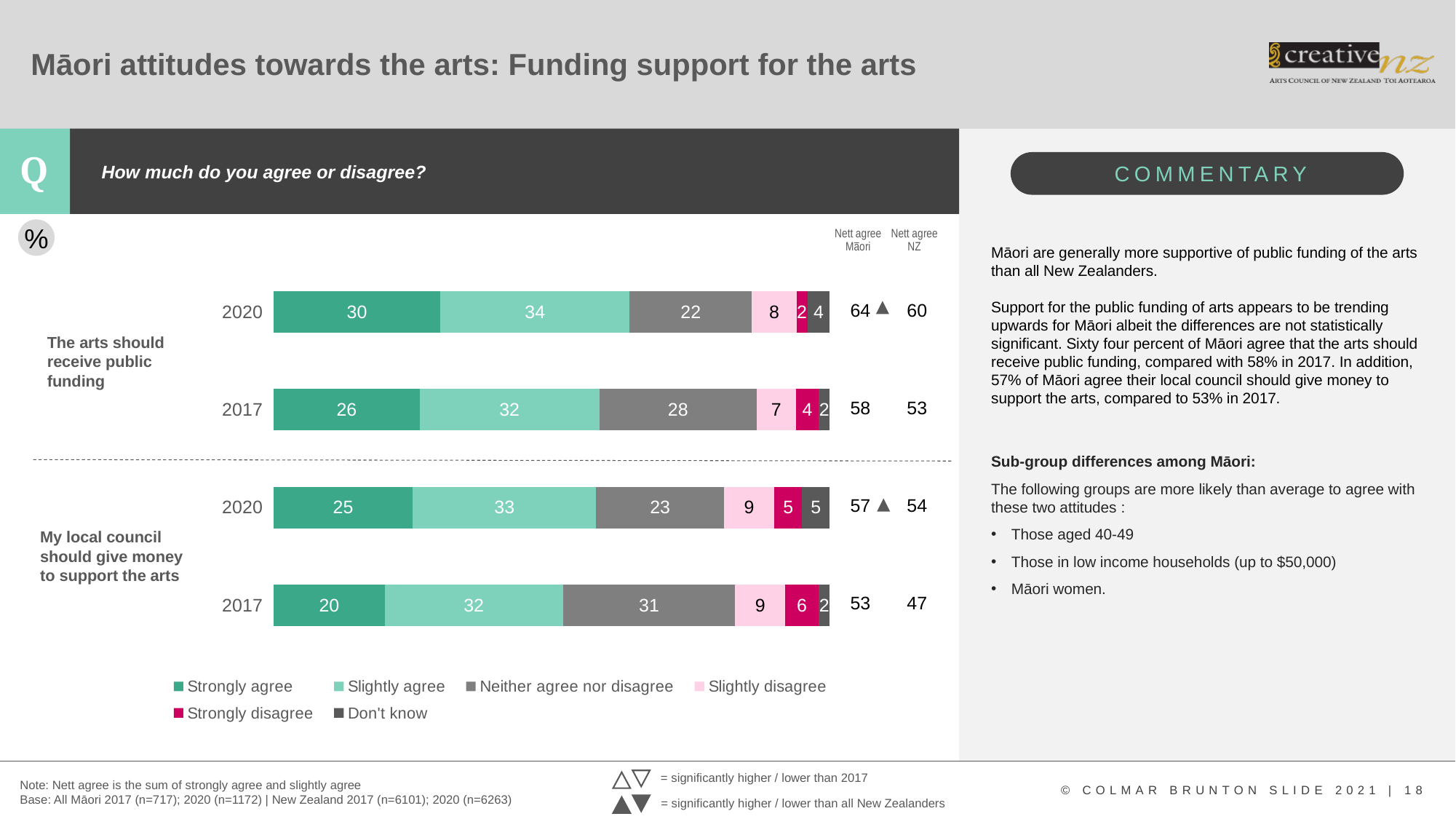
What is the Nett agree figure for NZ in 2017 for 'The arts should receive public funding'? 53 How many series does the legend list? 6 What kind of chart is shown on the slide? Stacked bar chart What percentage of Māori slightly agreed in 2017 that their local council should give money to support the arts? 32 Which is larger: the 'Neither agree nor disagree' value for 'My local council should give money to support the arts' in 2017 or in 2020? 2017 What is the difference between the 'Strongly agree' values for 'The arts should receive public funding' in 2020 and 2017? 4 What colour represents 'Strongly disagree' in the legend? Magenta/pink-red How many bars are plotted in the chart? 4 What is the Nett agree figure for Māori in 2020 for 'My local council should give money to support the arts'? 57 Which response category has the largest share in the 2017 bar for 'My local council should give money to support the arts'? Slightly agree Which response category has the smallest share in the 2020 bar for 'The arts should receive public funding'? Strongly disagree What percentage of Māori strongly agreed in 2020 that the arts should receive public funding? 30